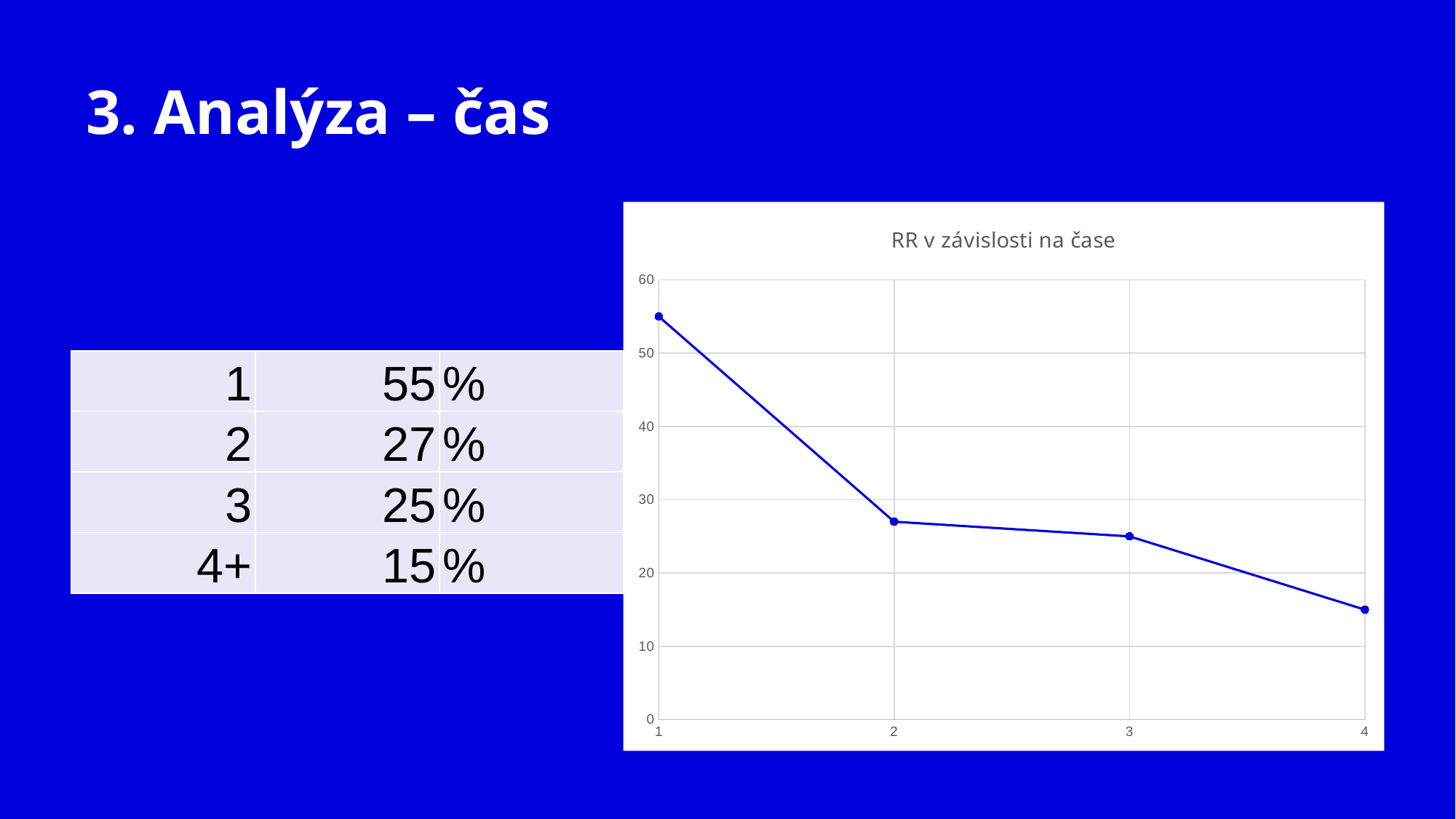
Which is larger, the value at x = 1 or the value at x = 2? x = 1 Is the value at x = 4 greater or less than 20? less How many data points are plotted on the line? 4 Is the value at x = 1 greater or less than 50? greater Is the value at x = 2 greater or less than 30? less What is the highest value shown on the chart's y axis? 60 At which x-axis value is the plotted value lowest? 4 Which is larger, the value at x = 3 or the value at x = 4? x = 3 At which x-axis value is the plotted value highest? 1 What is the title of the chart? RR v závislosti na čase What kind of chart is shown on the slide? line chart Do the values rise or fall along the x axis from 1 to 4? fall